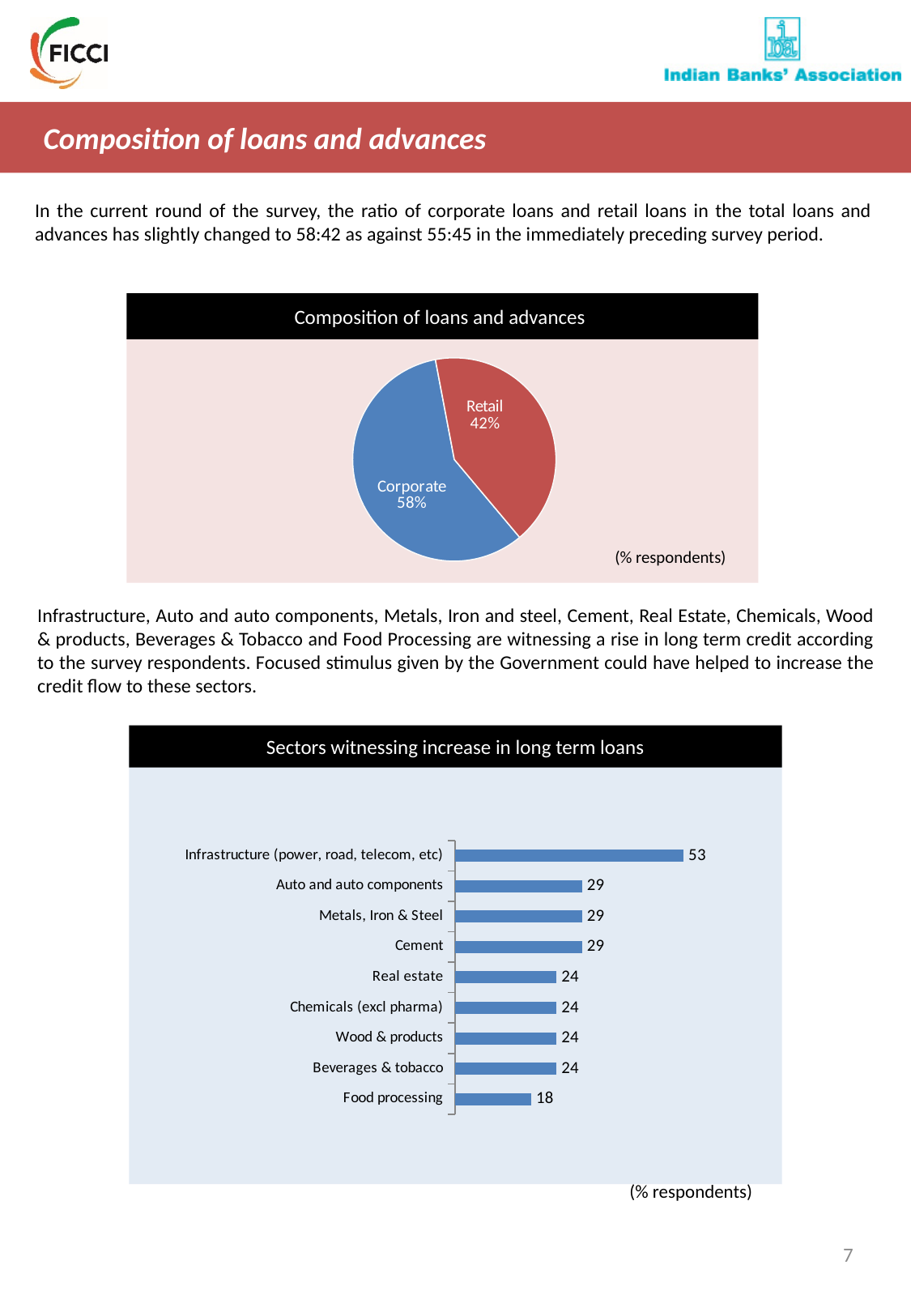
How many slices does the 'Composition of loans and advances' pie chart have? 2 How many sectors are shown in the 'Sectors witnessing increase in long term loans' chart? 9 In the 'Composition of loans and advances' chart, what share of loans and advances is Retail? 42% In the 'Composition of loans and advances' chart, what share of loans and advances is Corporate? 58% What kind of chart is the 'Sectors witnessing increase in long term loans' chart? Bar chart In the 'Sectors witnessing increase in long term loans' chart, what is the difference between Infrastructure (power, road, telecom, etc) and Cement? 24 In the 'Sectors witnessing increase in long term loans' chart, which sector has the lowest value? Food processing What kind of chart is the 'Composition of loans and advances' chart? Pie chart In the 'Sectors witnessing increase in long term loans' chart, which sector has the highest value? Infrastructure (power, road, telecom, etc) In the 'Sectors witnessing increase in long term loans' chart, what is the value for Food processing? 18 In the 'Composition of loans and advances' chart, which slice is larger, Corporate or Retail? Corporate In the 'Sectors witnessing increase in long term loans' chart, what is the value for Infrastructure (power, road, telecom, etc)? 53